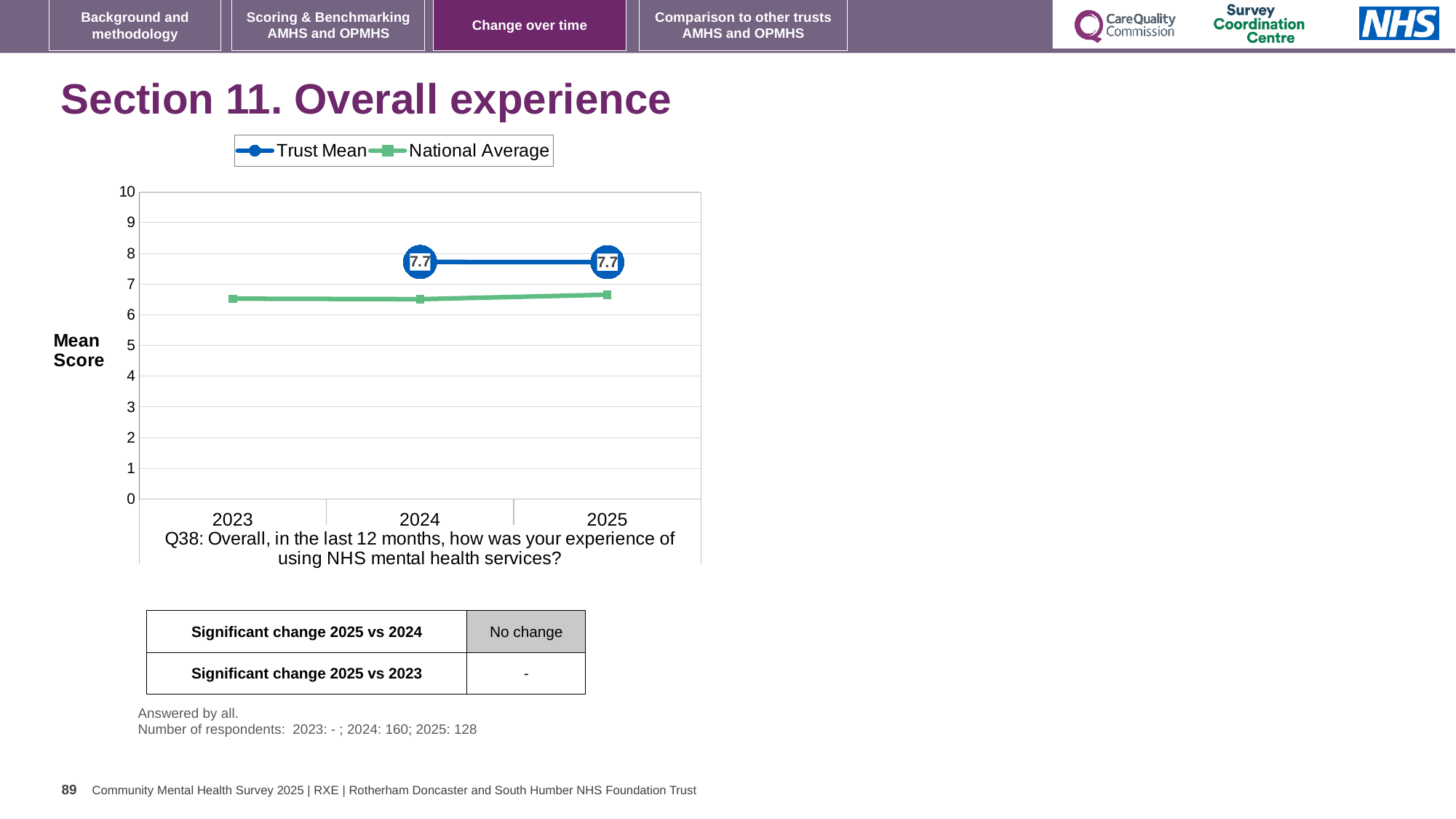
What is the Trust Mean value for 2025? 7.7 How many years are shown on the x axis of the chart? 3 Does the Trust Mean rise, fall or stay the same from 2024 to 2025? stays the same Is the National Average value for 2023 greater or less than 7? less What is the label on the y axis of the chart? Mean Score How many data points are plotted for the Trust Mean series? 2 How many series does the legend list? 2 What is the Trust Mean value for 2024? 7.7 What is the difference between the Trust Mean in 2025 and the Trust Mean in 2024? 0 Is the National Average value for 2025 greater or less than 6? greater In 2025, which is larger: the Trust Mean or the National Average? Trust Mean What kind of chart is shown on the slide? line chart